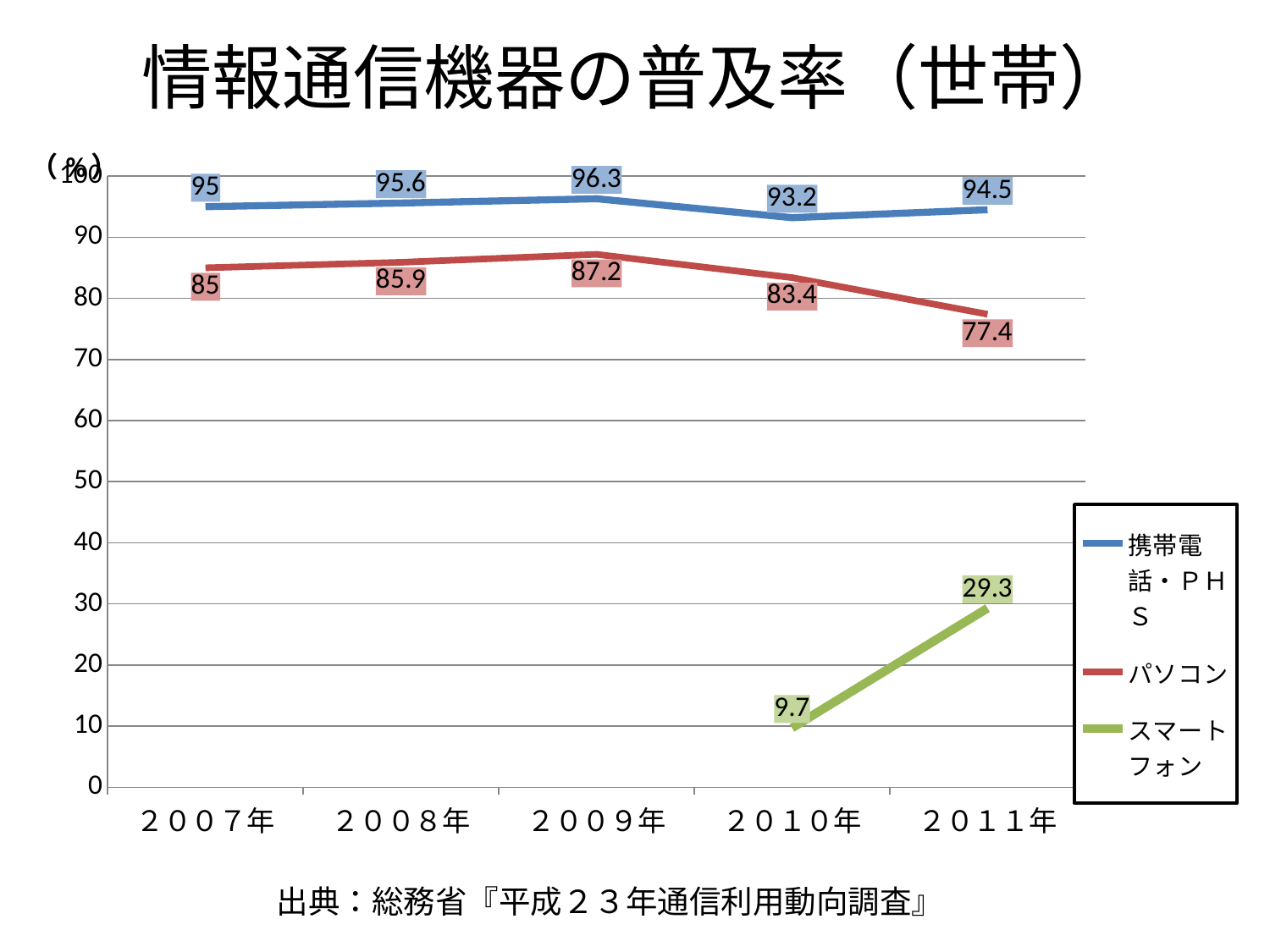
What is the value for パソコン in 2011年? 77.4 How many years are shown on the x axis? 5 What kind of chart is shown on the slide? line chart In which year is the value for 携帯電話・PHS lowest? 2010年 Which is larger in 2010年, the value for 携帯電話・PHS or the value for パソコン? 携帯電話・PHS What is the value for スマートフォン in 2010年? 9.7 How many series does the legend list? 3 What is the difference between the スマートフォン values for 2011年 and 2010年? 19.6 In which year is the value for パソコン highest? 2009年 Does the value for パソコン rise or fall from 2009年 to 2011年? fall What is the value for 携帯電話・PHS in 2009年? 96.3 Is the value for スマートフォン in 2011年 greater or less than 20? greater